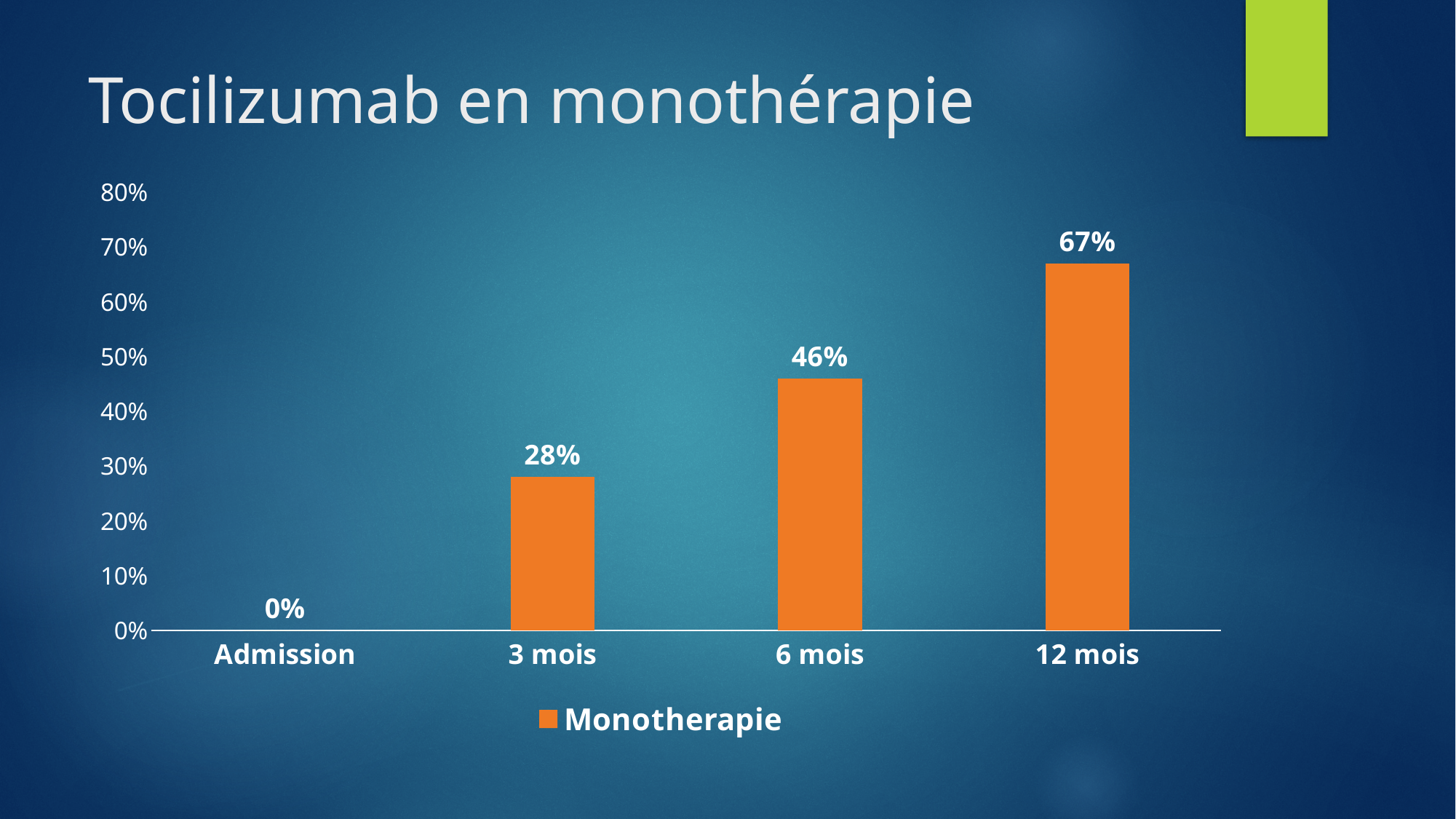
What is the value for Admission? 0% Which category has the highest value? 12 mois What is the value for 3 mois? 28% What is the difference between the values for 12 mois and 6 mois? 21% How many categories are shown on the x axis? 4 Which category has the lowest value? Admission What kind of chart is shown on the slide? bar chart Is the value for 6 mois greater or less than 40%? greater Which is larger, the value for 6 mois or the value for 3 mois? 6 mois What is the value for 12 mois? 67% How many series does the legend list? 1 Do the values rise or fall from Admission to 12 mois? rise